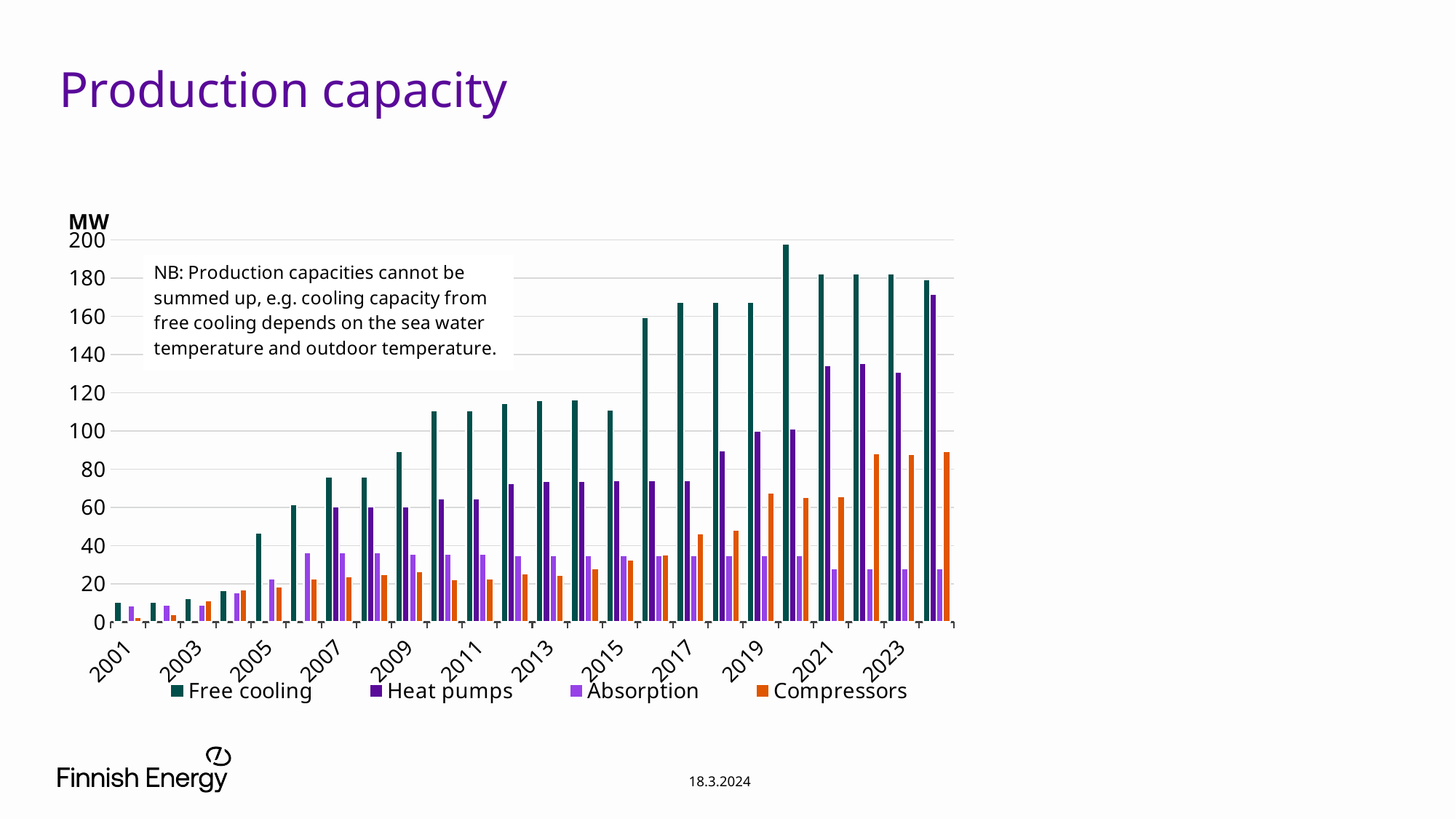
What kind of chart is shown on the slide? bar chart Is the Compressors value for 2023 greater or less than 80? greater In 2017, which is larger: Compressors or Absorption? Compressors In 2023, which is larger: Free cooling or Heat pumps? Free cooling Does the Free cooling capacity generally rise or fall from 2001 to 2023? rise Is the Heat pumps value for 2023 greater or less than 120? greater Is the Absorption value for 2023 greater or less than 40? less What is the title of the chart? Production capacity In which year is the Free cooling value highest? 2020 What unit is shown on the y axis? MW How many series does the legend list? 4